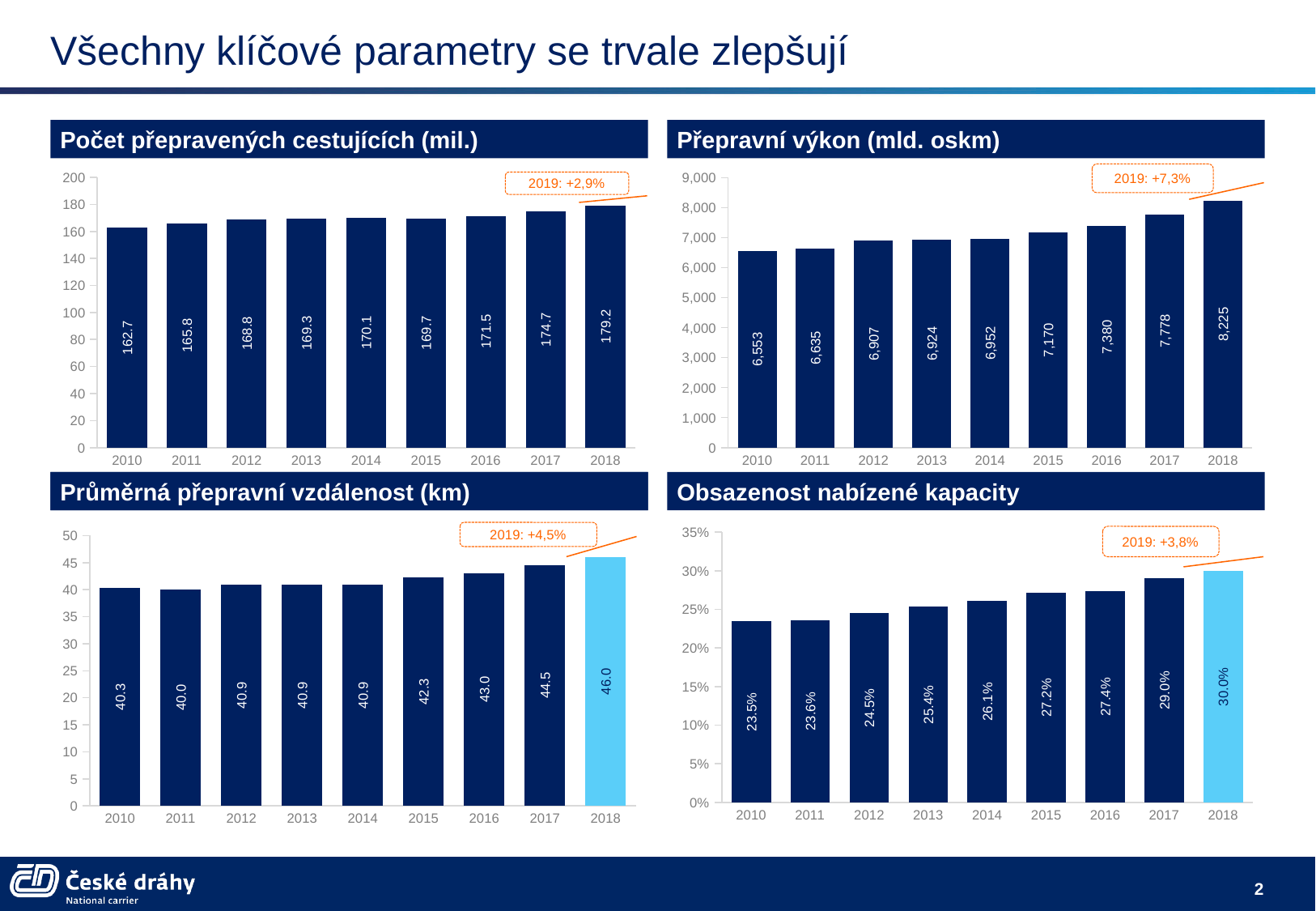
What is the title of the chart in the top-left of the slide? Počet přepravených cestujících (mil.) In the 'Počet přepravených cestujících (mil.)' chart, what is the value for 2018? 179.2 In the 'Přepravní výkon (mld. oskm)' chart, what is the value for 2015? 7,170 What kind of chart is the 'Obsazenost nabízené kapacity' chart? Bar chart In the 'Přepravní výkon (mld. oskm)' chart, do the values generally rise or fall from 2010 to 2018? Rise In the 'Přepravní výkon (mld. oskm)' chart, what is the difference between the 2018 and 2017 values? 447 In the 'Průměrná přepravní vzdálenost (km)' chart, which is larger, the value for 2015 or the value for 2016? 2016 In the 'Průměrná přepravní vzdálenost (km)' chart, which year has the lowest value? 2011 In the 'Obsazenost nabízené kapacity' chart, what is the value for 2014? 26.1% How many years are shown on the x axis of the 'Přepravní výkon (mld. oskm)' chart? 9 In the 'Obsazenost nabízené kapacity' chart, which year has the highest value? 2018 In the 'Počet přepravených cestujících (mil.)' chart, what is the difference between the 2018 and 2010 values? 16.5